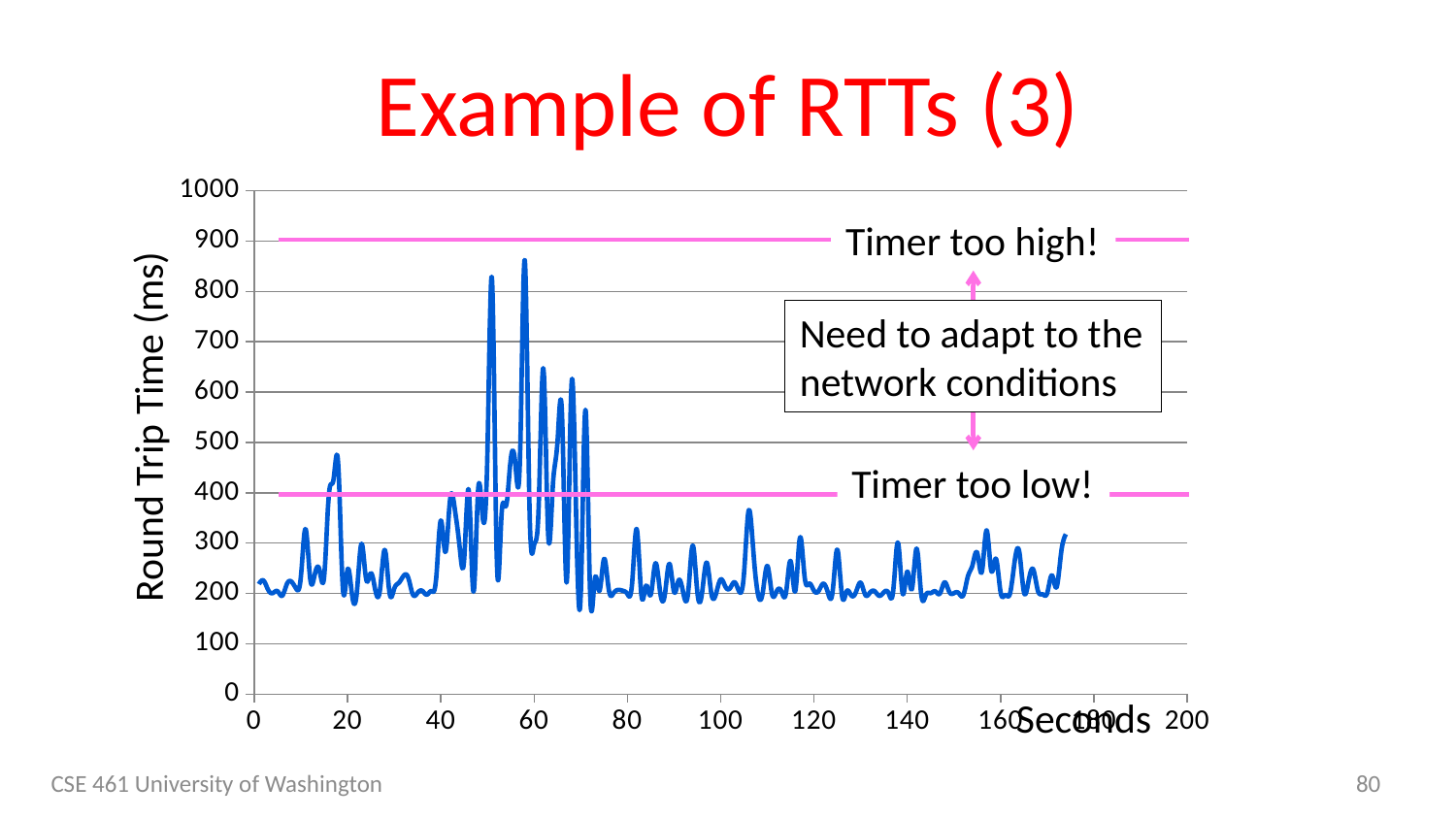
What is the title of the slide containing the chart? Example of RTTs (3) What is the label on the vertical axis of the chart? Round Trip Time (ms) Is the highest round trip time plotted on the chart greater or less than 800? greater Is the lowest round trip time plotted on the chart greater or less than 100? greater Is the highest round trip time plotted on the chart greater or less than 900? less What is the highest tick value shown on the vertical axis? 1000 What kind of chart is shown on the slide? line chart What is the highest tick value shown on the horizontal axis? 200